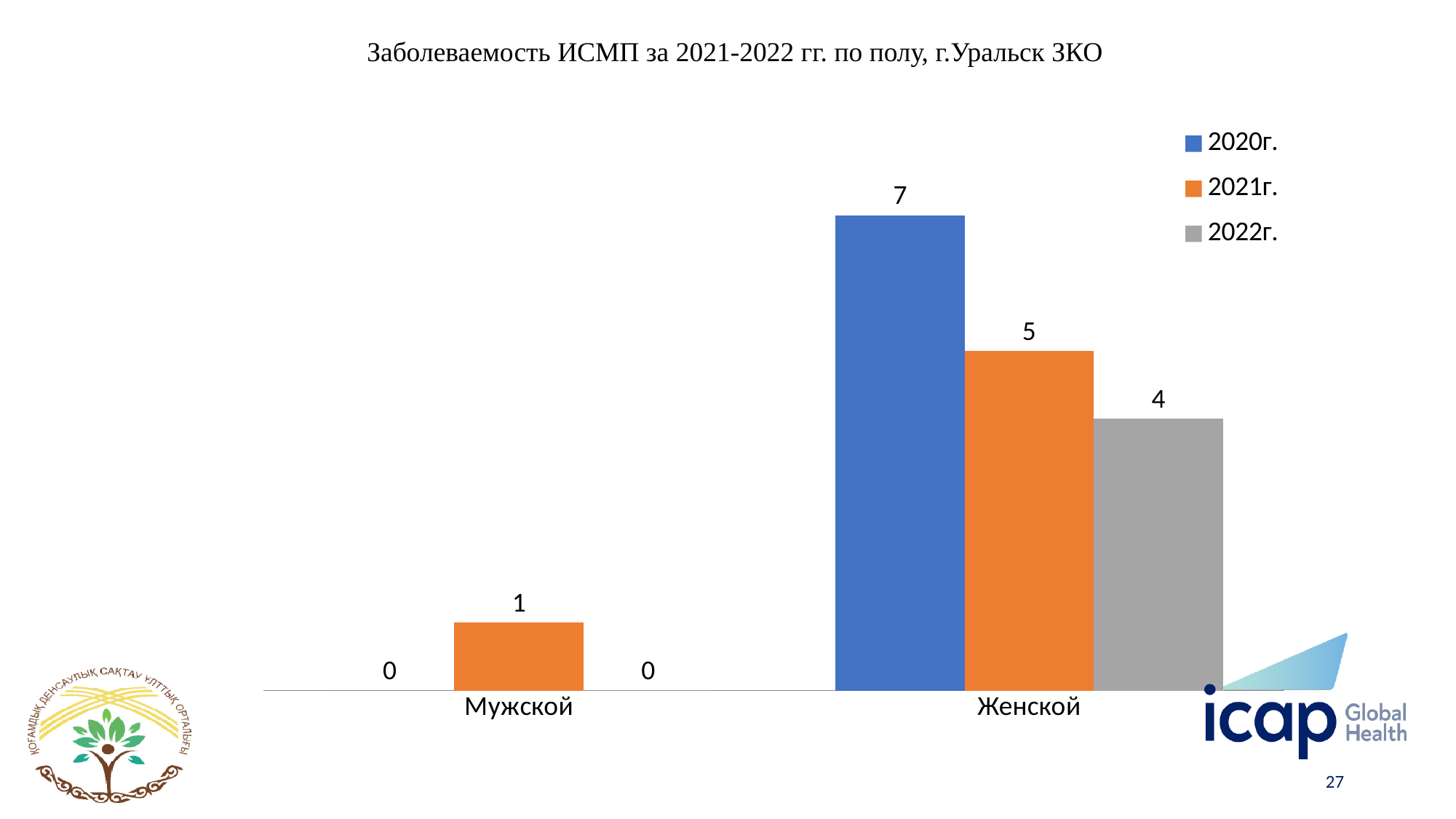
How many categories are shown on the x axis? 2 What is the value for Мужской in the 2020г. series? 0 What is the value for Мужской in the 2021г. series? 1 What is the value for Женской in the 2022г. series? 4 What is the title of the chart? Заболеваемость ИСМП за 2021-2022 гг. по полу, г.Уральск ЗКО Which is larger: the 2021г. value for Женской or the 2021г. value for Мужской? Женской Which series has the highest value for Женской? 2020г. What kind of chart is shown on the slide? Bar chart What is the value for Женской in the 2020г. series? 7 What is the difference between the 2020г. and 2022г. values for Женской? 3 How many series does the legend list? 3 What is the value for Женской in the 2021г. series? 5